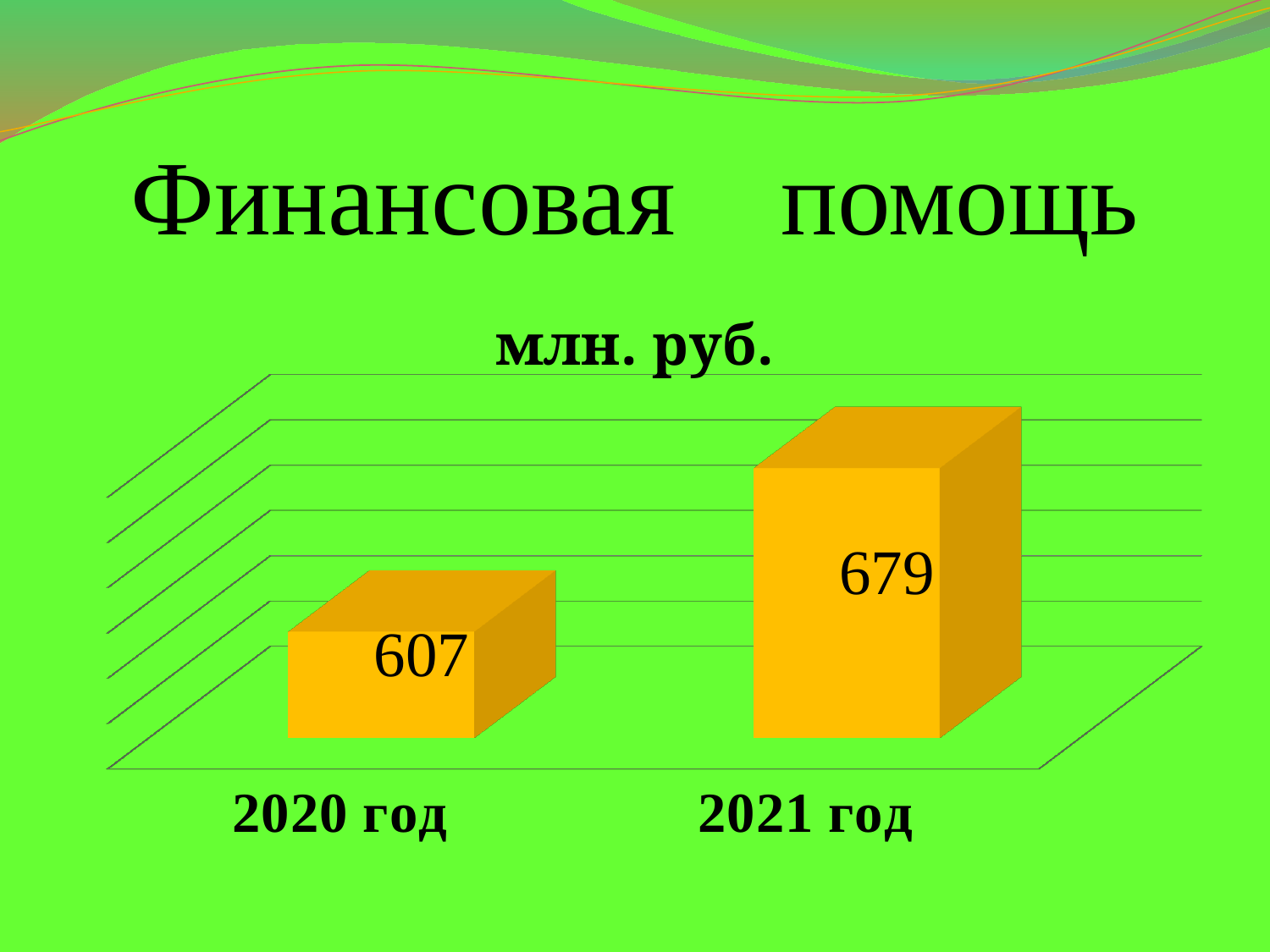
How many categories are shown in the chart? 2 Which year has the highest value? 2021 год What is the value for 2020 год? 607 What kind of chart is shown on the slide? bar chart What is the difference between the values for 2021 год and 2020 год? 72 Which year has the lowest value? 2020 год What is the title of the chart? млн. руб. Do the values rise or fall from 2020 год to 2021 год? rise What colour are the bars in the chart? orange Which is larger, the value for 2020 год or the value for 2021 год? 2021 год What is the value for 2021 год? 679